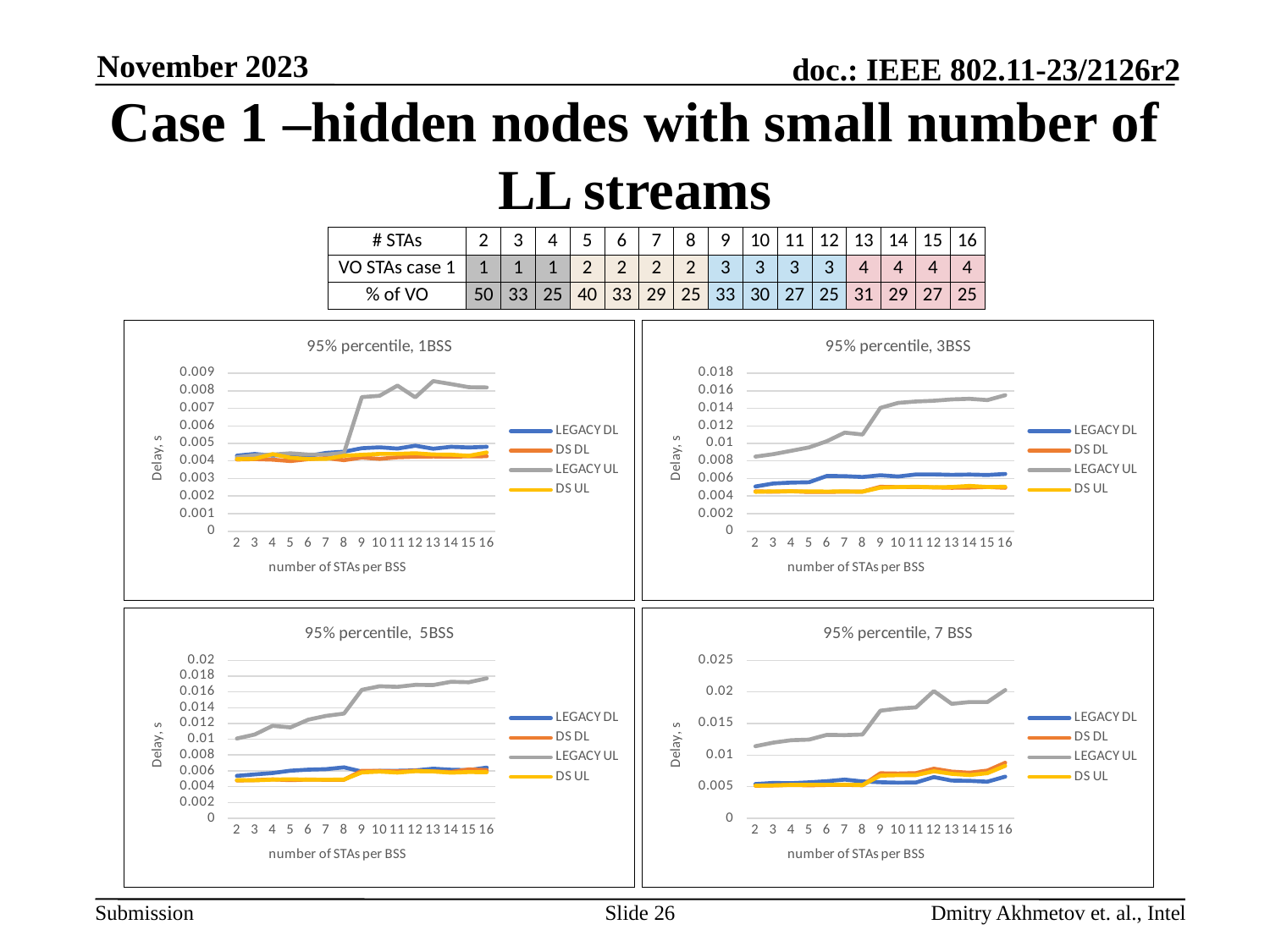
In the '95% percentile, 3BSS' chart, is the LEGACY UL value at 16 STAs greater or less than 0.014? greater In the '95% percentile, 7 BSS' chart, which series has the highest values across the x axis? LEGACY UL In the '95% percentile, 1BSS' chart, which is larger at 16 STAs: LEGACY UL or DS UL? LEGACY UL What kind of chart is the '95% percentile, 1BSS' chart? line chart How many series does the legend of the '95% percentile, 3BSS' chart list? 4 In the '95% percentile, 1BSS' chart, is the LEGACY UL value at 16 STAs greater or less than 0.007? greater How many x-axis points (number of STAs per BSS) are plotted in the '95% percentile, 5BSS' chart? 15 In the '95% percentile, 7 BSS' chart, is the LEGACY DL value at 16 STAs greater or less than 0.01? less In the '95% percentile, 3BSS' chart, does the LEGACY UL series rise or fall overall as the number of STAs per BSS increases? rise What is the y-axis label of the '95% percentile, 5BSS' chart? Delay, s